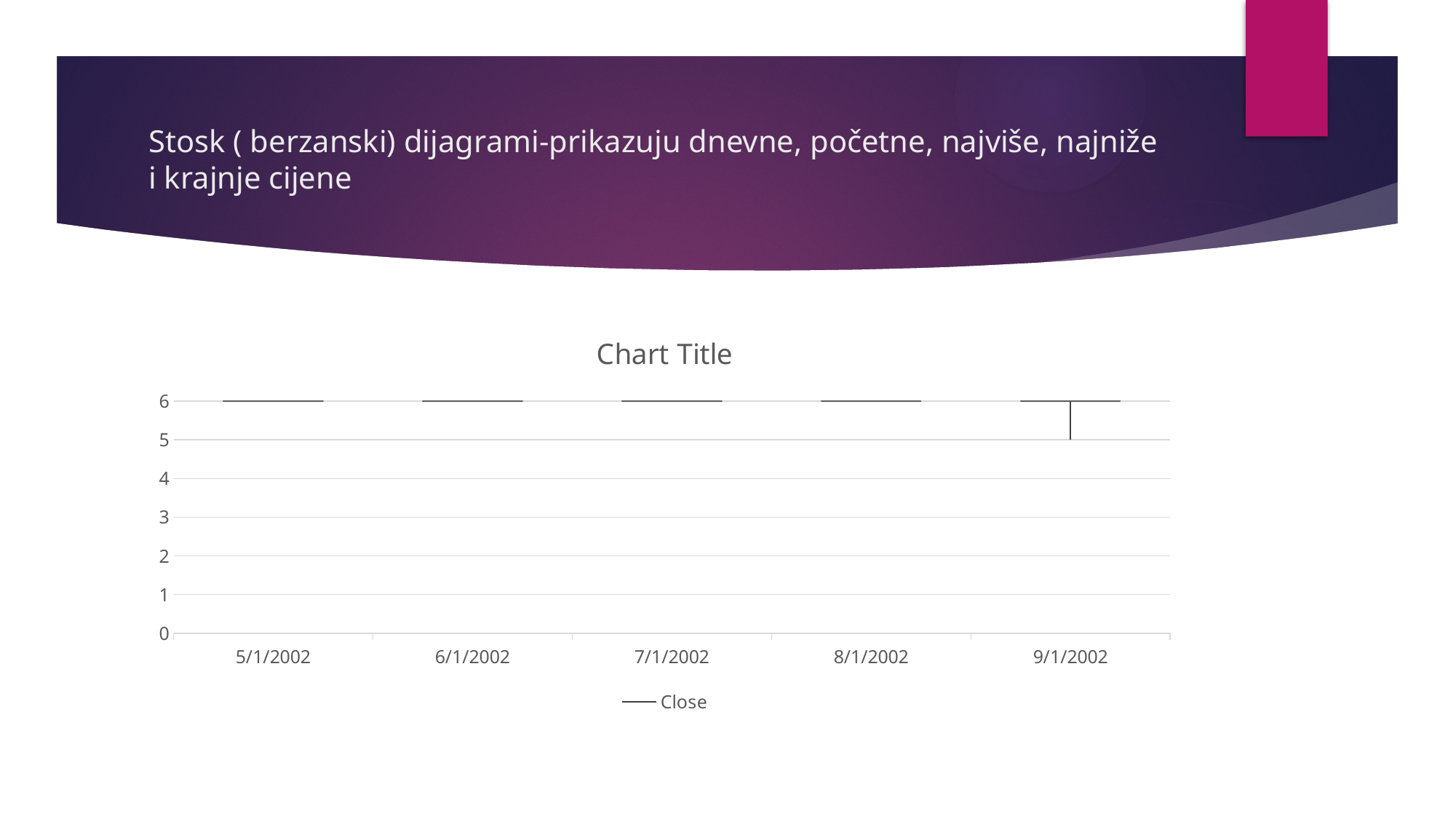
Is the Close value for 7/1/2002 greater or less than 3? greater What is the title of the chart? Chart Title How many dates are shown on the x axis? 5 What is the highest value labelled on the y axis? 6 How many series does the legend list? 1 What kind of chart is shown on the slide? stock chart What is the first date shown on the x axis? 5/1/2002 What is the name of the series shown in the legend? Close Which date shows a vertical high-low line extending below the Close marker? 9/1/2002